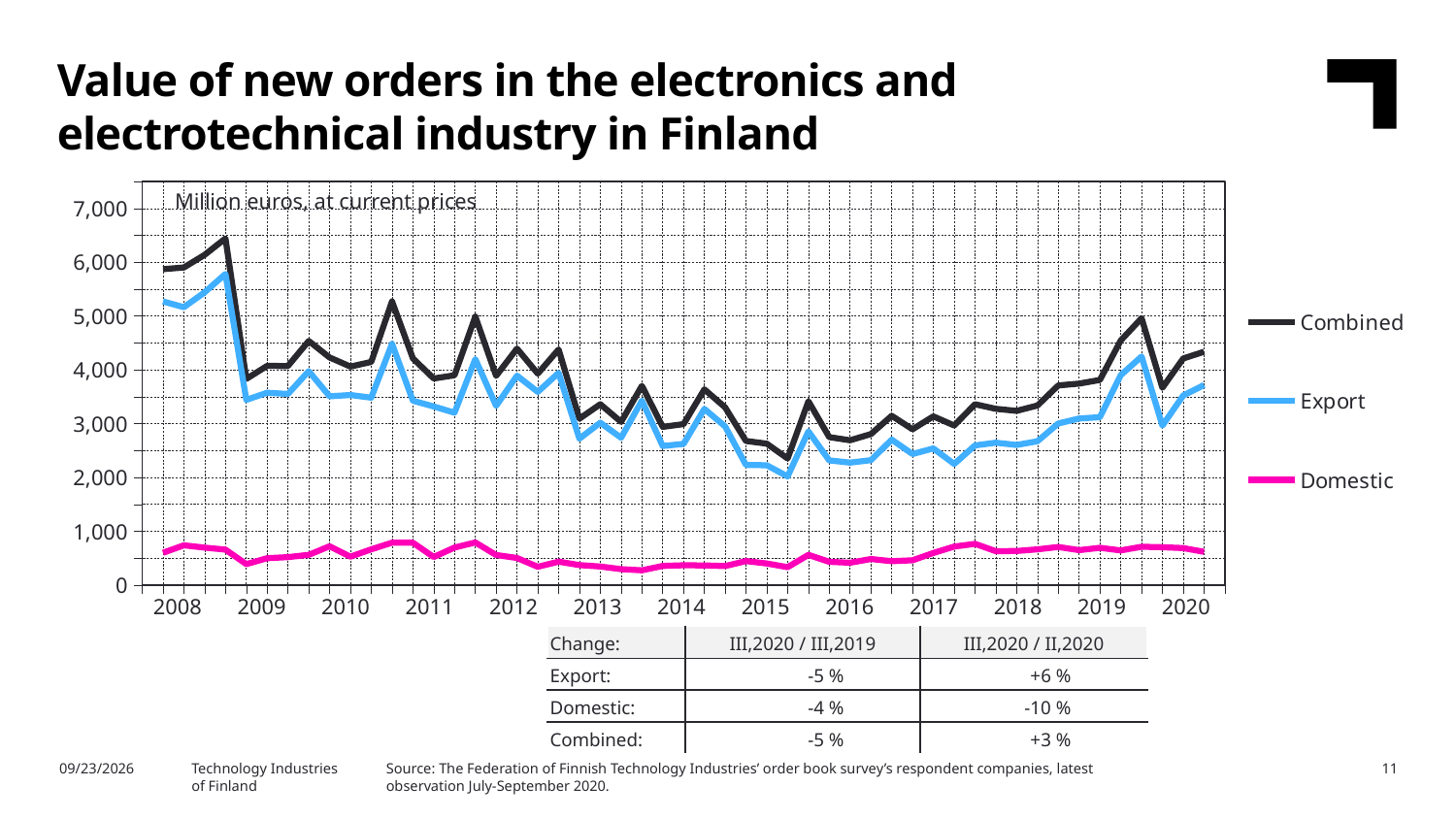
Which series has the highest values throughout the chart? Combined Is the Domestic series ever greater or less than 1,000 across the whole chart? less How many series does the chart's legend list? 3 What kind of chart is shown on the slide? Line chart What unit label is printed inside the chart area? Million euros, at current prices Which series has the lowest values throughout the chart? Domestic Which is larger in 2008, the Combined series or the Domestic series? Combined How many year labels are shown on the x axis? 13 Is the peak value of the Combined series in 2008 greater or less than 6,000? greater Does the Combined series generally rise or fall from 2008 to 2013? Fall Is the Export value at the end of the chart in 2020 greater or less than 3,000? greater What are the three series named in the chart's legend? Combined, Export, Domestic